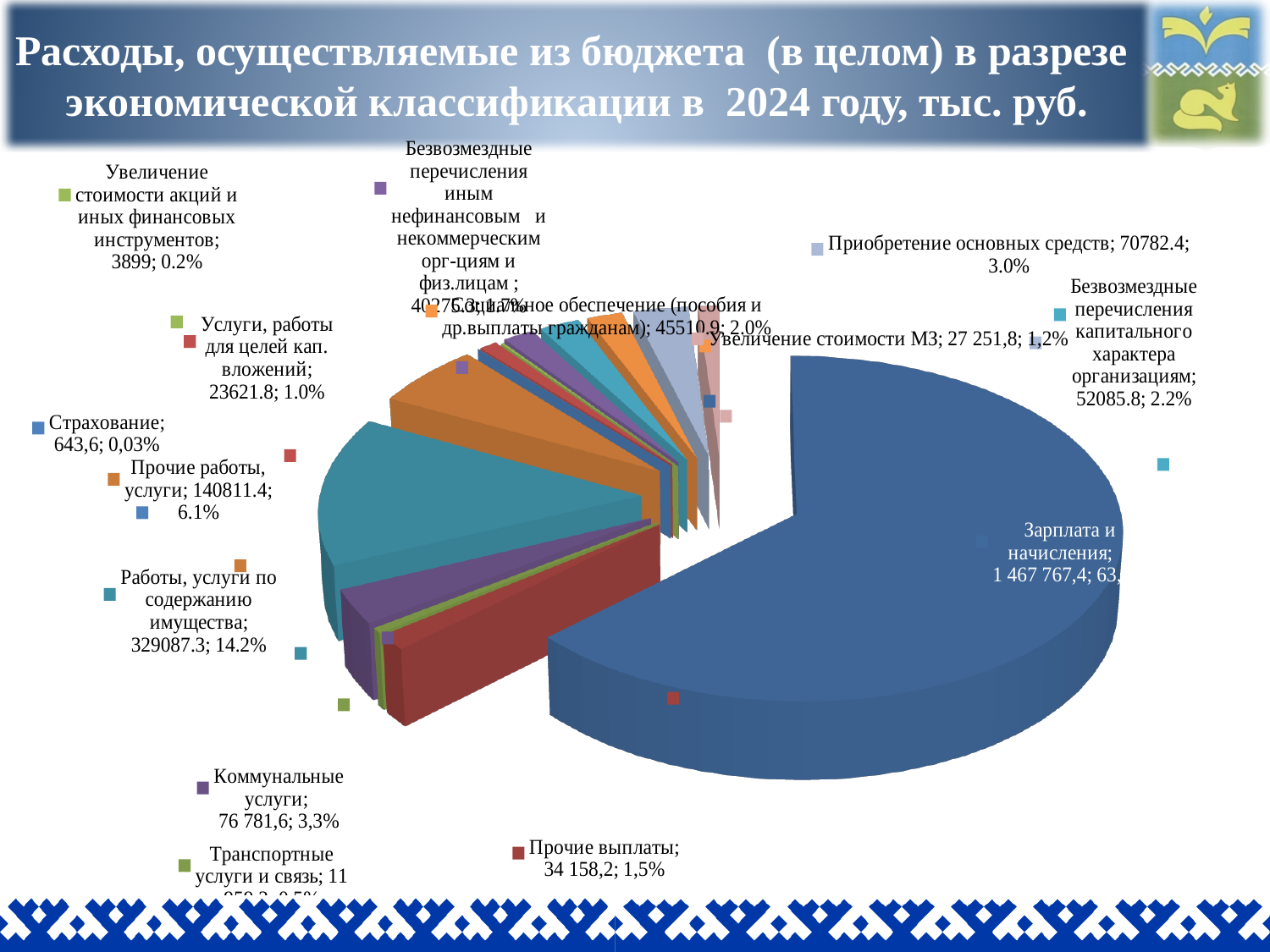
Which category has the largest slice of the pie? Зарплата и начисления Which category has the smallest slice of the pie? Страхование What is the value shown for Приобретение основных средств? 70782.4 What share of the pie does Коммунальные услуги represent? 3,3% What year does the chart title refer to? 2024 How many categories (slices) does the pie chart have? 14 What is the difference in percentage share between Работы, услуги по содержанию имущества (14.2%) and Прочие работы, услуги (6.1%)? 8.1% What is the value shown for Прочие выплаты? 34 158,2 What share of the pie does Работы, услуги по содержанию имущества represent? 14.2% What is the value shown for Страхование? 643,6 What kind of chart is shown on the slide? Pie chart Which is larger: Прочие работы, услуги or Коммунальные услуги? Прочие работы, услуги